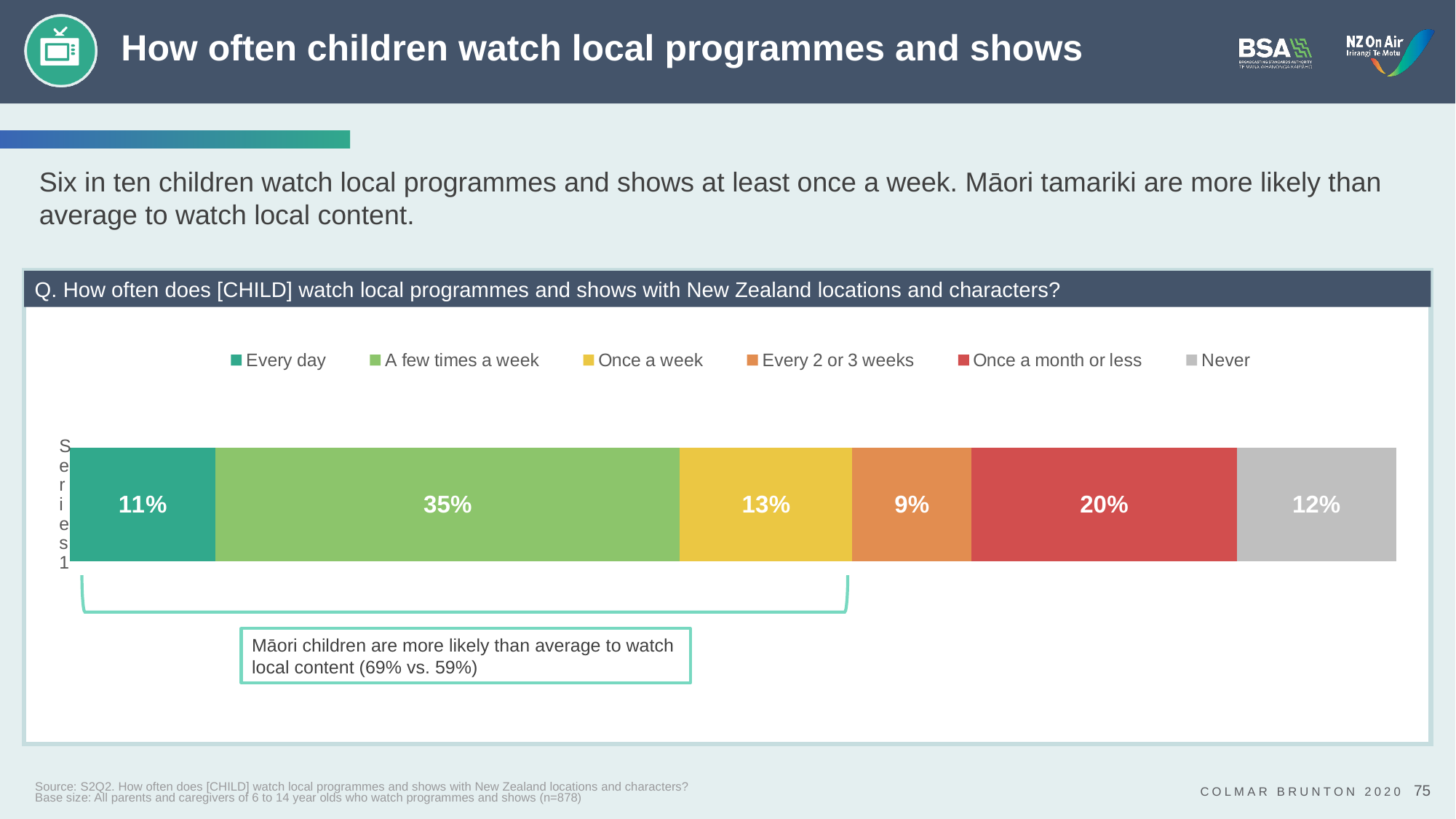
What percentage of children watch local programmes and shows once a week? 13% Which is larger: the share for 'Once a month or less' or the share for 'Never'? Once a month or less What percentage of children watch local programmes and shows every 2 or 3 weeks? 9% What is the difference in percentage points between 'A few times a week' and 'Once a month or less'? 15 How many frequency categories does the legend list? 6 Which frequency category has the largest share of children? A few times a week What percentage of children watch local programmes and shows every day? 11% Which frequency category has the smallest share of children? Every 2 or 3 weeks What percentage of children never watch local programmes and shows? 12% What type of chart is shown on the slide? Stacked bar chart What percentage of children watch local programmes and shows a few times a week? 35% What colour is the 'Every day' segment in the chart? Green (teal)